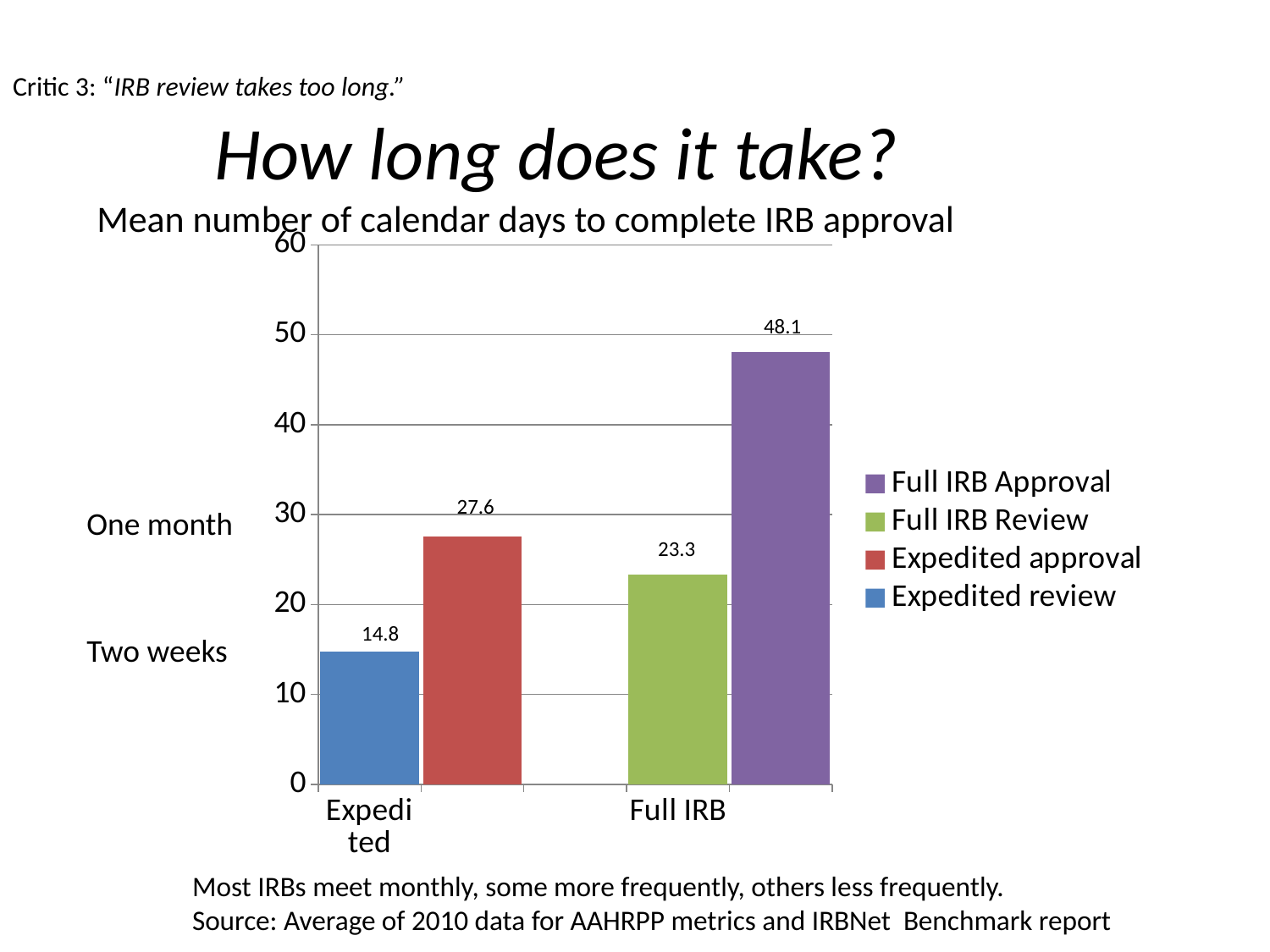
Which is larger, Expedited approval or Full IRB Review? Expedited approval What is the difference in days between Full IRB Approval and Expedited approval? 20.5 What colour is the bar for Full IRB Approval? Purple What is the difference in days between Expedited approval and Expedited review? 12.8 What kind of chart is shown on the slide? Bar chart What is the mean number of calendar days for Expedited approval? 27.6 How many series does the legend list? 4 What is the mean number of calendar days for Expedited review? 14.8 What is the mean number of calendar days for Full IRB Approval? 48.1 What is the mean number of calendar days for Full IRB Review? 23.3 Which series has the lowest value on the chart? Expedited review Which series has the highest value on the chart? Full IRB Approval